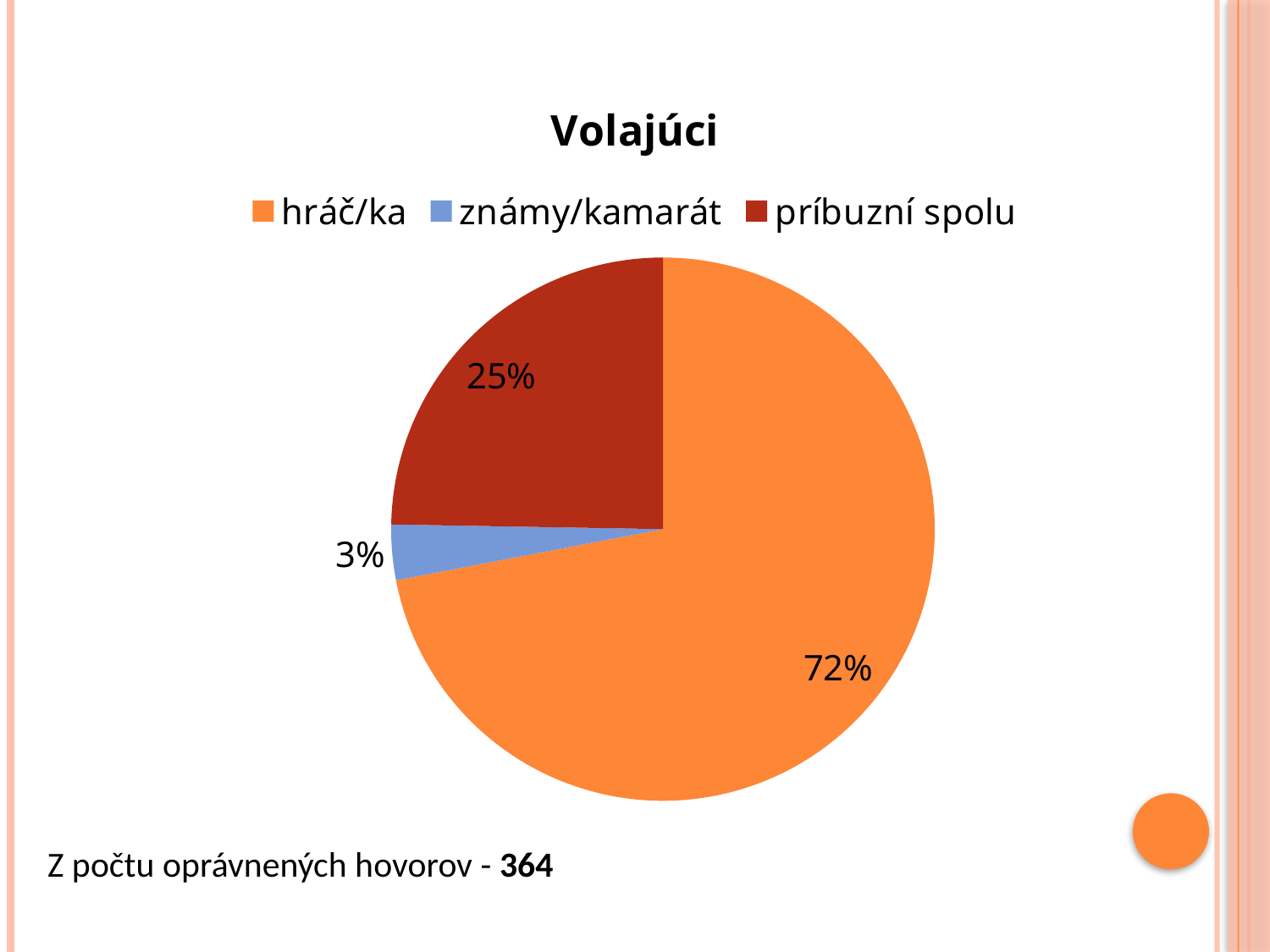
What colour is the slice for známy/kamarát? blue What share of the pie does hráč/ka have? 72% Which category has the largest slice of the pie? hráč/ka What type of chart is shown on the slide? pie chart What is the difference in percentage points between hráč/ka and príbuzní spolu? 47 Which is larger, the slice for príbuzní spolu or the slice for známy/kamarát? príbuzní spolu Which category has the smallest slice of the pie? známy/kamarát What is the difference in percentage points between príbuzní spolu and známy/kamarát? 22 How many categories does the pie chart have? 3 What is the title of the chart? Volajúci What share of the pie does známy/kamarát have? 3% What share of the pie does príbuzní spolu have? 25%